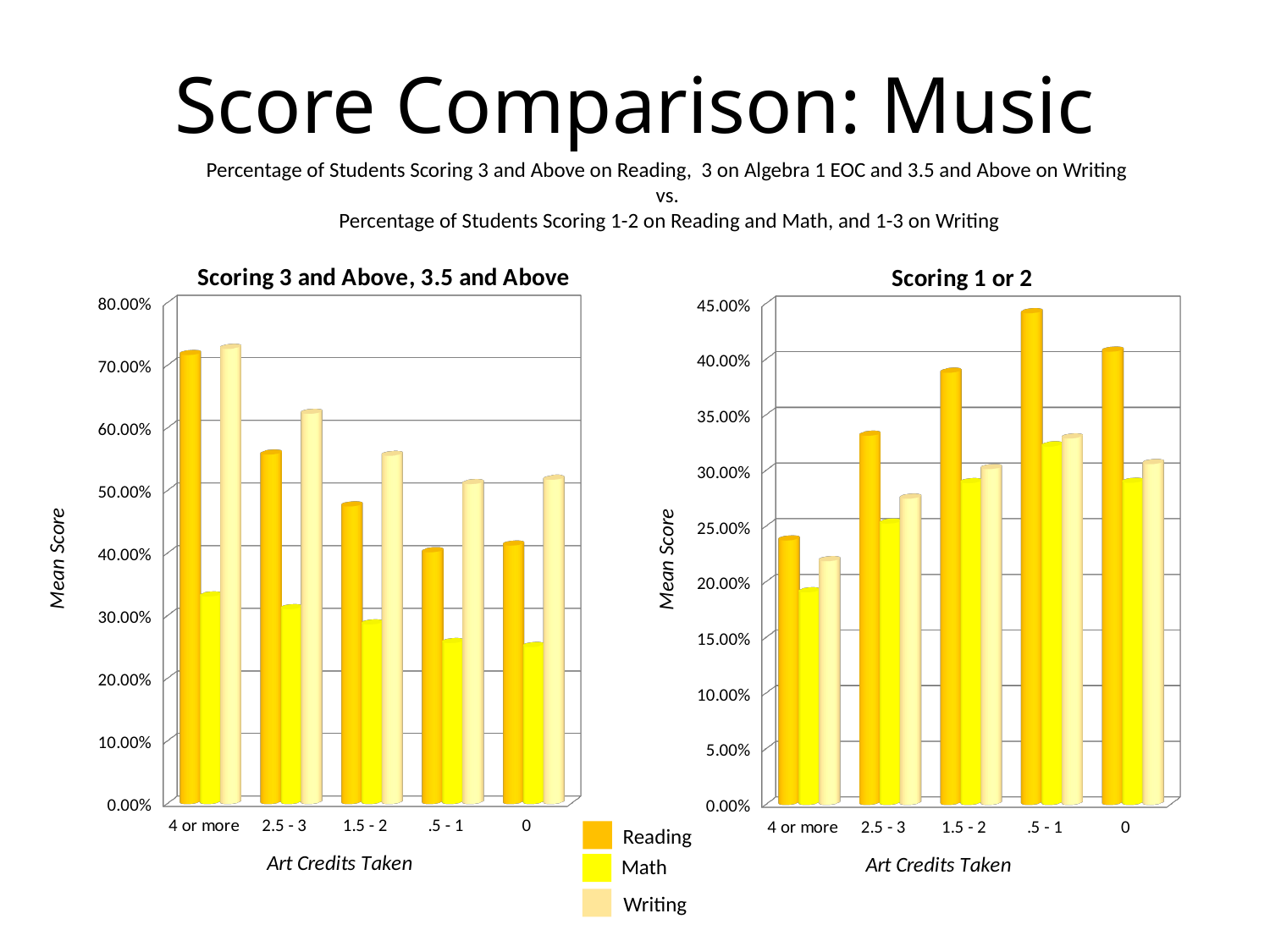
In the "Scoring 3 and Above, 3.5 and Above" chart, which category has the highest Reading value? 4 or more In the "Scoring 1 or 2" chart, how many categories are shown on the x axis? 5 What kind of chart is the "Scoring 3 and Above, 3.5 and Above" chart? bar chart In the "Scoring 1 or 2" chart, is the Math value for "4 or more" greater or less than 25.00%? less How many series does the legend list for the charts? 3 In the "Scoring 1 or 2" chart, which category has the highest Reading value? .5 - 1 In the "Scoring 3 and Above, 3.5 and Above" chart, is the Reading value for "4 or more" greater or less than 60.00%? greater What is the x-axis title of the "Scoring 1 or 2" chart? Art Credits Taken In the "Scoring 1 or 2" chart, is the Reading value for ".5 - 1" greater or less than 40.00%? greater In the "Scoring 1 or 2" chart, which category has the lowest Reading value? 4 or more In the "Scoring 3 and Above, 3.5 and Above" chart, for "4 or more", which is larger: Reading or Math? Reading